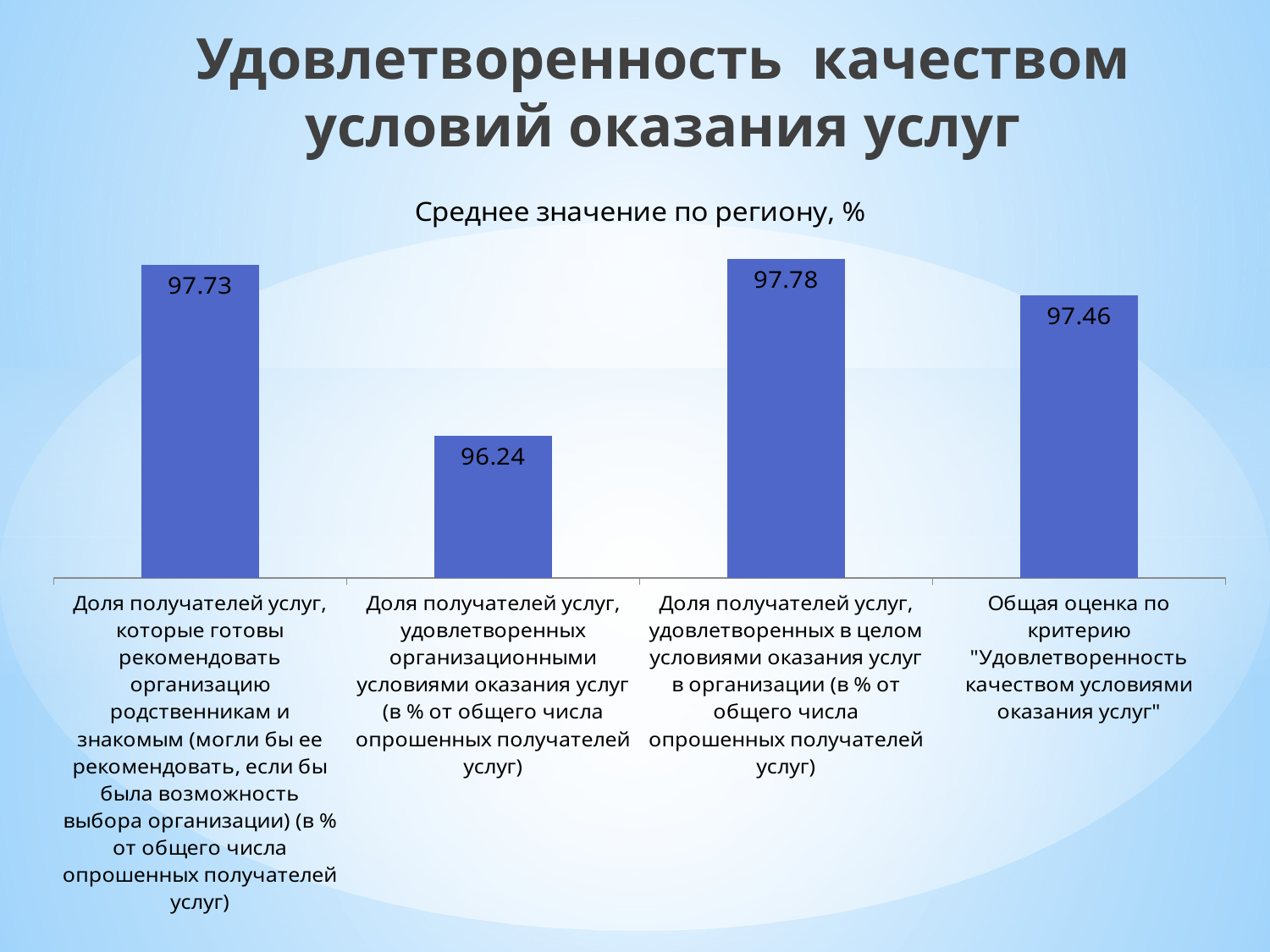
Which category has the lowest value? Доля получателей услуг, удовлетворенных организационными условиями оказания услуг What is the value for 'Доля получателей услуг, удовлетворенных в целом условиями оказания услуг в организации'? 97.78 Which is larger: the value for 'Доля получателей услуг, удовлетворенных организационными условиями' or the value for 'Общая оценка по критерию'? Общая оценка по критерию What type of chart is shown on the slide? Bar chart What is the value for 'Доля получателей услуг, которые готовы рекомендовать организацию родственникам и знакомым'? 97.73 What is the difference between the highest value (97.78) and the lowest value (96.24)? 1.54 What is the difference between the value for 'Доля получателей услуг, которые готовы рекомендовать организацию' (97.73) and 'Общая оценка по критерию' (97.46)? 0.27 Which category has the highest value? Доля получателей услуг, удовлетворенных в целом условиями оказания услуг в организации What is the title of the chart? Среднее значение по региону, % How many categories are shown in the chart? 4 What is the value for 'Общая оценка по критерию "Удовлетворенность качеством условиями оказания услуг"'? 97.46 What is the value for 'Доля получателей услуг, удовлетворенных организационными условиями оказания услуг'? 96.24